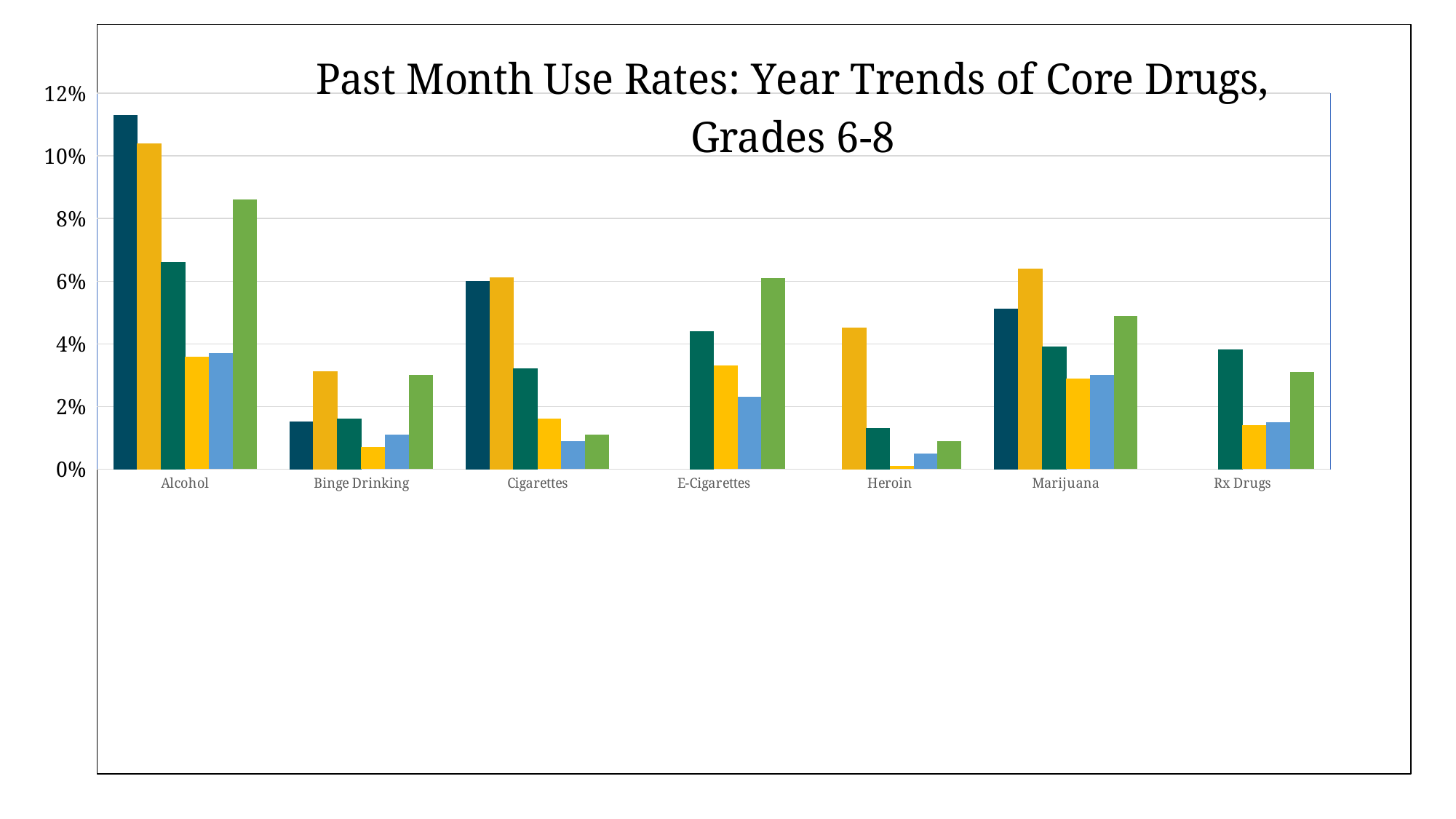
Which category has the tallest bar on the chart? Alcohol Which category contains the shortest bar on the chart? Heroin How many categories are shown on the x axis of the chart? 7 Is the tallest bar for E-Cigarettes greater or less than 8%? less Is the tallest bar for Binge Drinking greater or less than 4%? less Is the tallest bar for Heroin greater or less than 6%? less Which category has the taller tallest bar, Alcohol or Marijuana? Alcohol How many bars are plotted for the Alcohol category? 6 What is the title of the chart? Past Month Use Rates: Year Trends of Core Drugs, Grades 6-8 What kind of chart is shown on the slide? bar chart